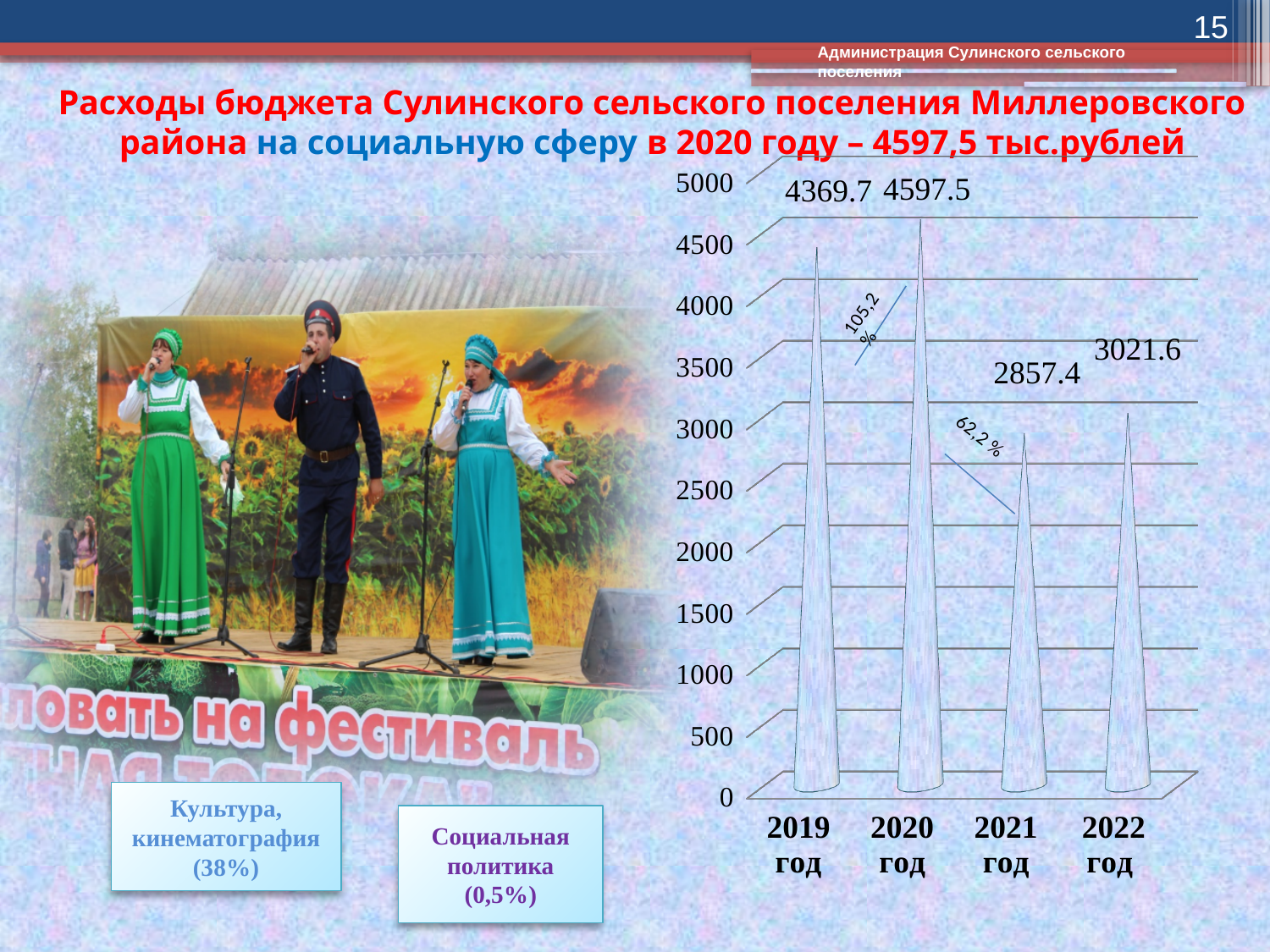
What percentage label is shown between the 2019 год and 2020 год bars? 105,2 % What is the difference between the values for 2020 год and 2019 год? 227.8 How many years are shown on the x axis of the chart? 4 What percentage label is shown between the 2020 год and 2021 год bars? 62,2 % Which year has the lowest value? 2021 год Which year has the highest value? 2020 год What is the value for 2020 год? 4597.5 What is the value for 2022 год? 3021.6 What is the value for 2021 год? 2857.4 Which is larger, the value for 2019 год or the value for 2021 год? 2019 год What is the value for 2019 год? 4369.7 What is the difference between the values for 2022 год and 2021 год? 164.2